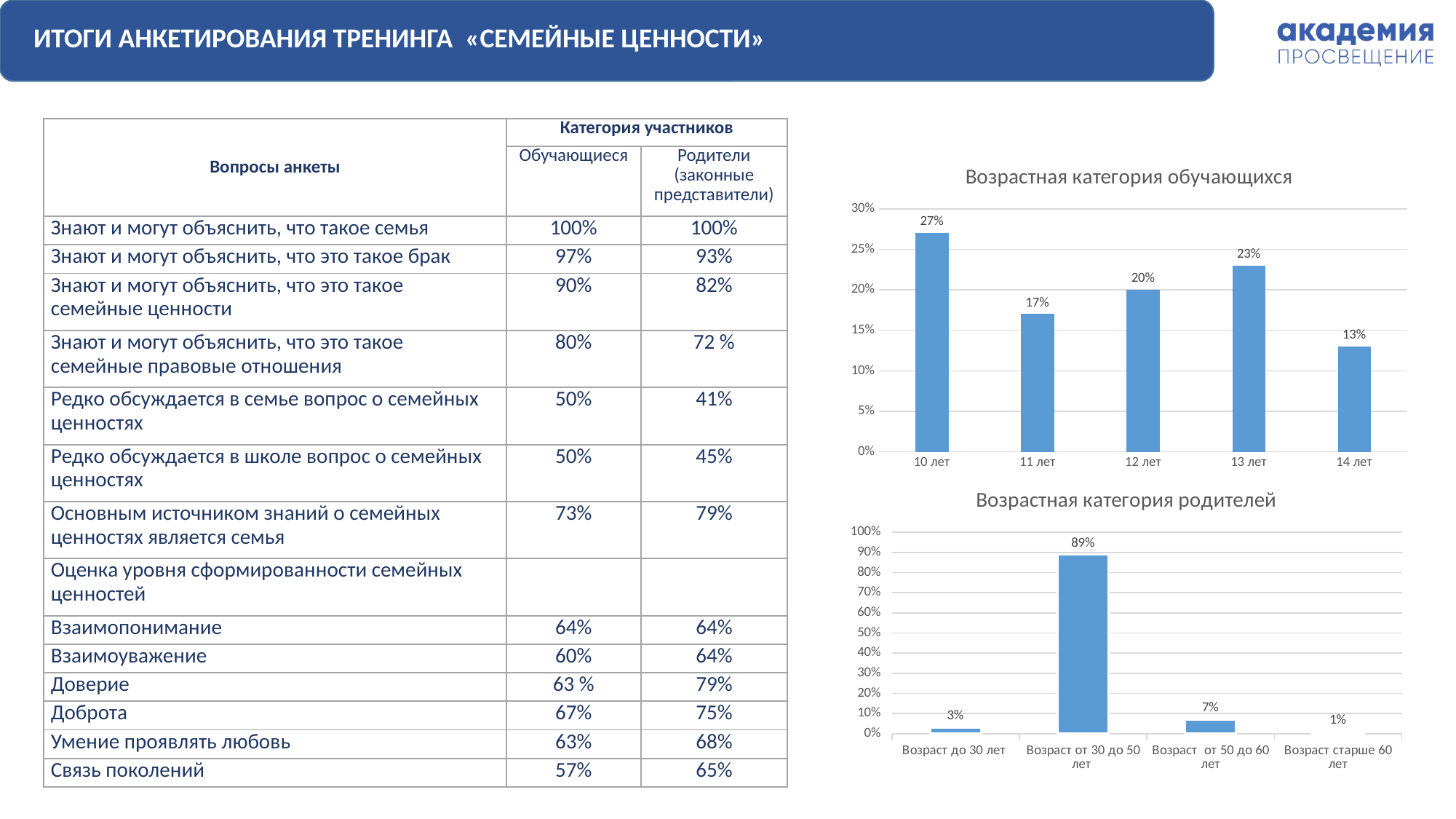
In the chart "Возрастная категория обучающихся", which age category has the highest value? 10 лет In the chart "Возрастная категория родителей", what is the value for "Возраст от 30 до 50 лет"? 89% In the chart "Возрастная категория обучающихся", what is the value for 10 лет? 27% In the chart "Возрастная категория обучающихся", is the value for 12 лет greater or less than 15%? greater What type of chart is "Возрастная категория родителей"? Bar chart In the chart "Возрастная категория родителей", which is larger: the value for "Возраст до 30 лет" or "Возраст от 50 до 60 лет"? Возраст от 50 до 60 лет In the chart "Возрастная категория родителей", what is the value for "Возраст старше 60 лет"? 1% In the chart "Возрастная категория родителей", what is the difference between the values for "Возраст от 30 до 50 лет" and "Возраст от 50 до 60 лет"? 82% In the chart "Возрастная категория обучающихся", how many age categories are shown? 5 In the chart "Возрастная категория обучающихся", what is the value for 13 лет? 23% In the chart "Возрастная категория обучающихся", which age category has the lowest value? 14 лет In the chart "Возрастная категория обучающихся", what is the difference between the values for 12 лет and 11 лет? 3%